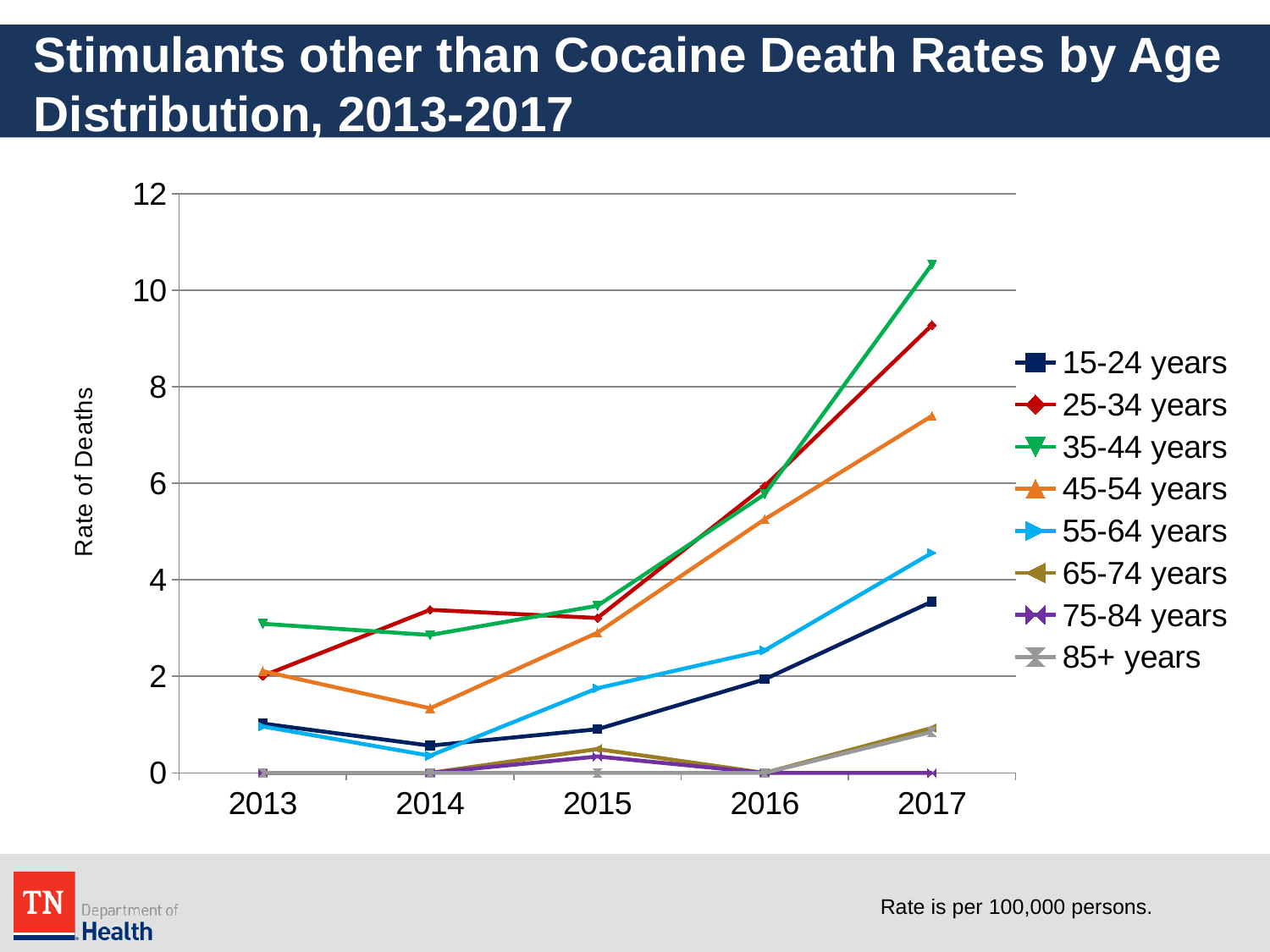
What is the label of the y axis? Rate of Deaths Is the value for 35-44 years in 2017 greater or less than 10? greater Does the value for 45-54 years rise or fall from 2014 to 2017? rise Is the value for 25-34 years in 2017 greater or less than 8? greater Which is larger in 2014, the value for 25-34 years or 35-44 years? 25-34 years How many years are shown on the x axis? 5 Is the value for 55-64 years in 2017 greater or less than 4? greater Which age group has the highest death rate in 2017? 35-44 years What kind of chart is shown on the slide? line chart How many series does the legend list? 8 What is the death rate for 75-84 years in 2017? 0